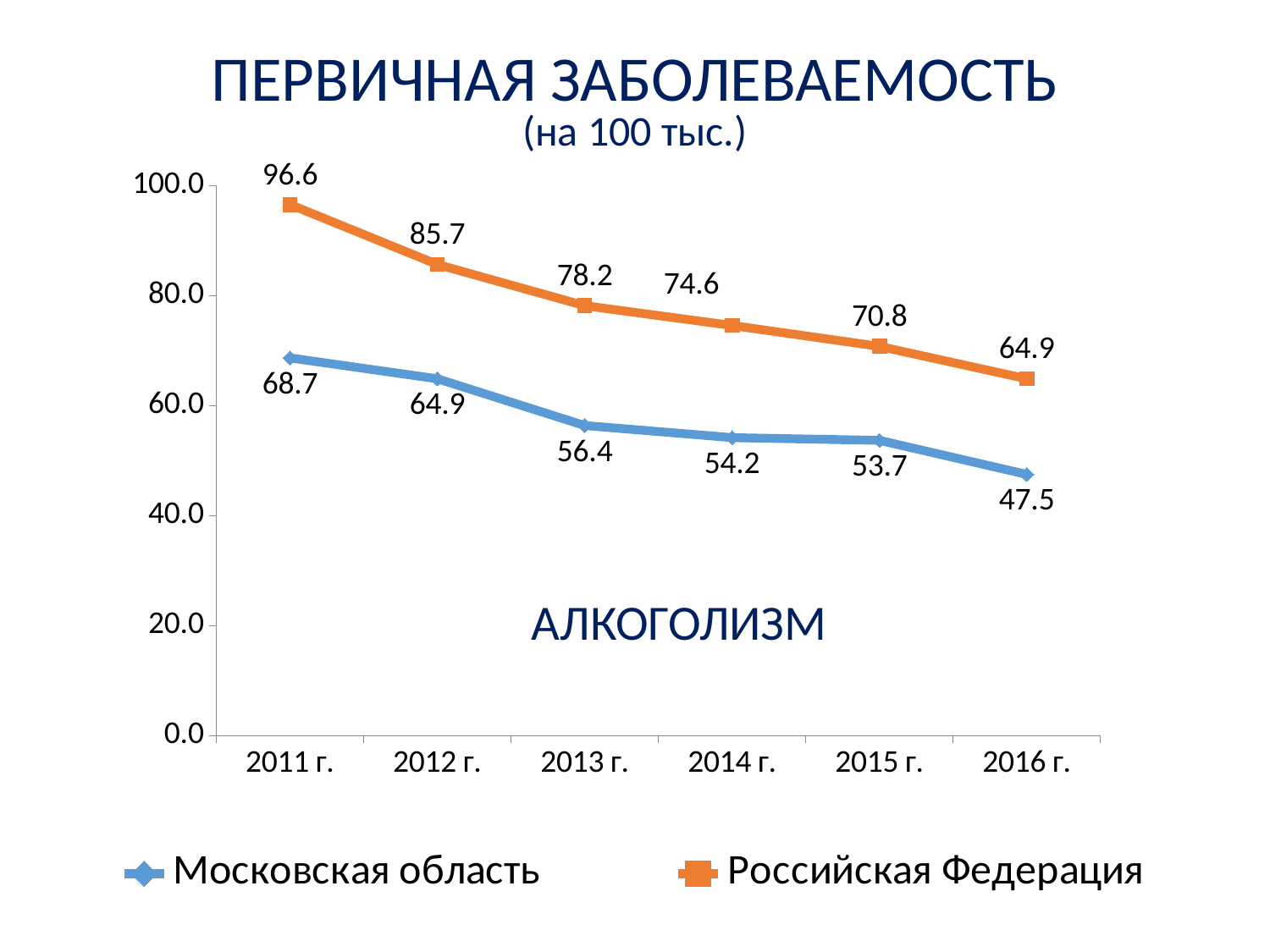
In which year is the value for Московская область highest? 2011 г. What type of chart is shown on the slide? line chart What is the difference between Российская Федерация and Московская область in 2013 г.? 21.8 Which series has the larger value in 2012 г., Московская область or Российская Федерация? Российская Федерация What is the value for Московская область in 2014 г.? 54.2 In which year is the value for Российская Федерация lowest? 2016 г. How many series does the legend list? 2 What is the value for Российская Федерация in 2011 г.? 96.6 Do the values for Российская Федерация rise or fall from 2011 г. to 2016 г.? fall How many years are shown on the x axis? 6 What is the value for Российская Федерация in 2015 г.? 70.8 What is the value for Московская область in 2016 г.? 47.5